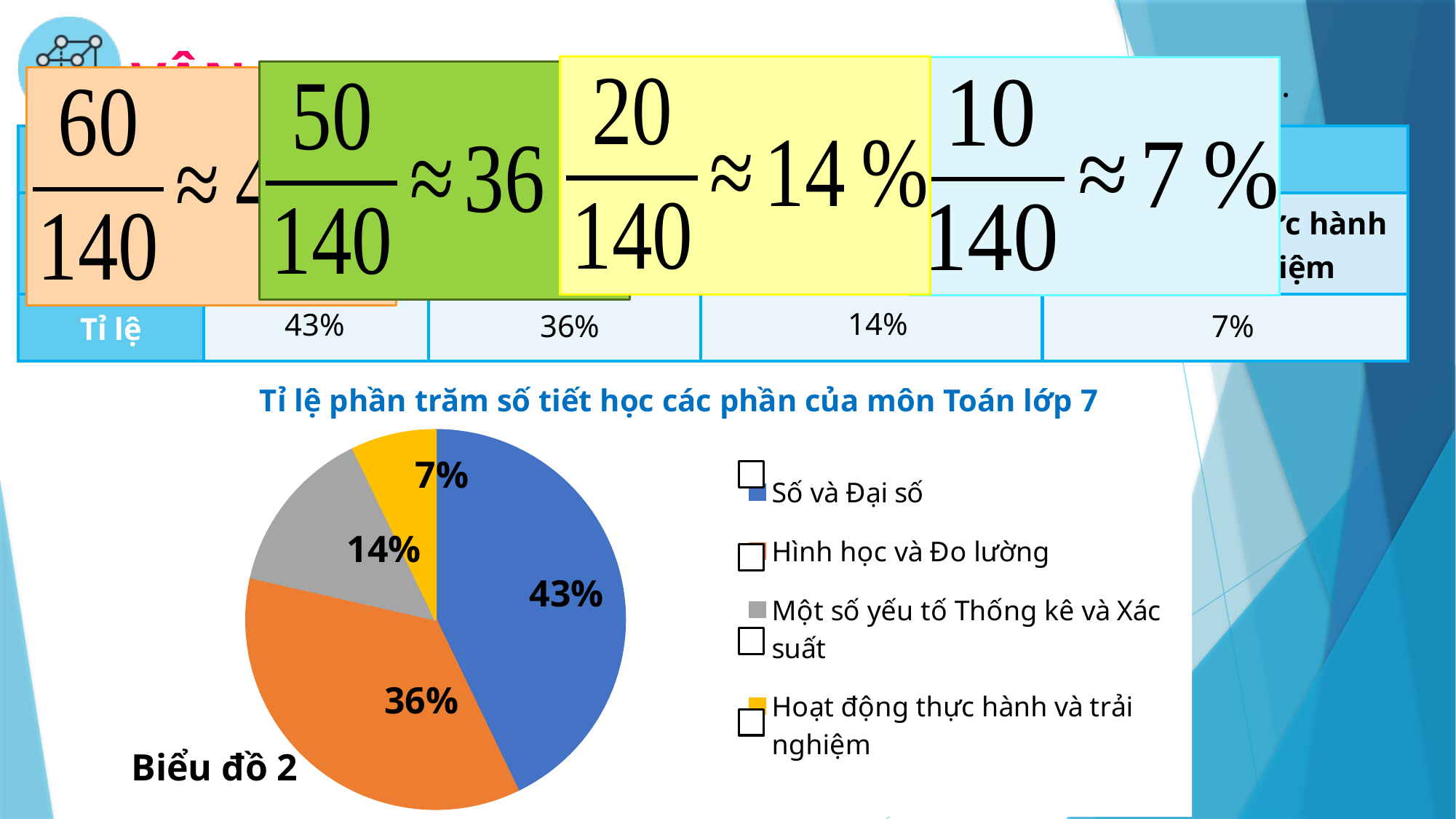
What percentage of the pie chart is Một số yếu tố Thống kê và Xác suất? 14% What colour is the slice for Hình học và Đo lường? orange What percentage of the pie chart is Hình học và Đo lường? 36% What percentage of the pie chart is Hoạt động thực hành và trải nghiệm? 7% What percentage of the pie chart is Số và Đại số? 43% Which category has the smallest slice of the pie chart? Hoạt động thực hành và trải nghiệm Which category has the largest slice of the pie chart? Số và Đại số Which is larger: the slice for Một số yếu tố Thống kê và Xác suất or the slice for Hoạt động thực hành và trải nghiệm? Một số yếu tố Thống kê và Xác suất How many slices does the pie chart have? 4 What is the difference in percentage points between Số và Đại số and Hình học và Đo lường? 7 What type of chart is shown on the slide? pie chart What is the title of the pie chart? Tỉ lệ phần trăm số tiết học các phần của môn Toán lớp 7